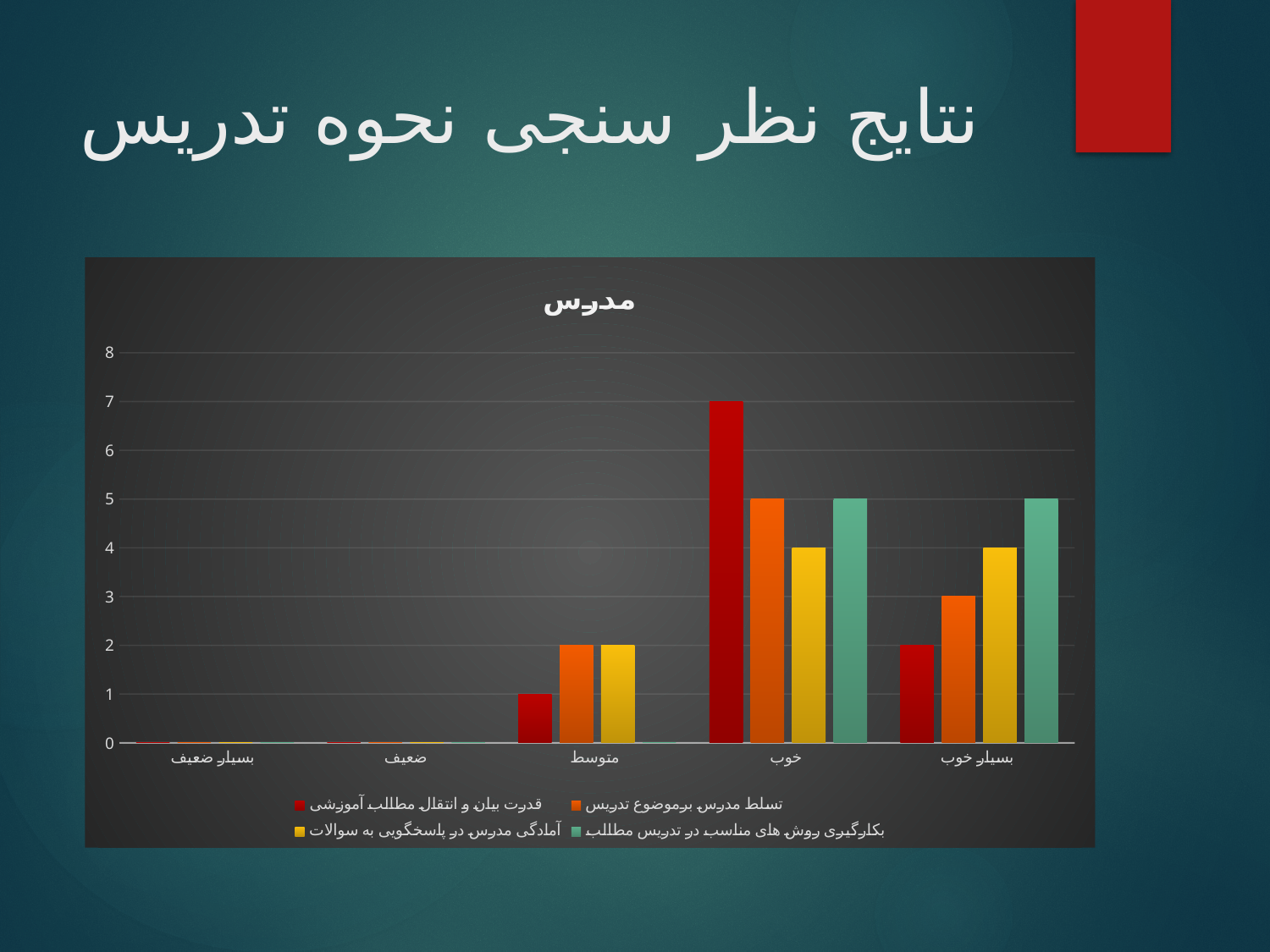
Is the value for قدرت بیان و انتقال مطلب آموزشی in the خوب category greater or less than 6? greater What type of chart is shown on the slide? bar chart What colour are the bars for قدرت بیان و انتقال مطلب آموزشی? red What is the value for آمادگی مدرس در پاسخگویی به سوالات in the متوسط category? 2 In the بسیار خوب category, which is larger: بکارگیری روش های مناسب در تدریس مطلب or تسلط مدرس برموضوع تدریس? بکارگیری روش های مناسب در تدریس مطلب What is the value for قدرت بیان و انتقال مطلب آموزشی in the خوب category? 7 What is the title of the chart? مدرس Which category has the highest value for قدرت بیان و انتقال مطلب آموزشی? خوب What is the value for تسلط مدرس برموضوع تدریس in the بسیار خوب category? 3 How many series does the legend list? 4 How many categories are shown on the x axis? 5 What is the difference between the value for قدرت بیان و انتقال مطلب آموزشی in خوب and in بسیار خوب? 5